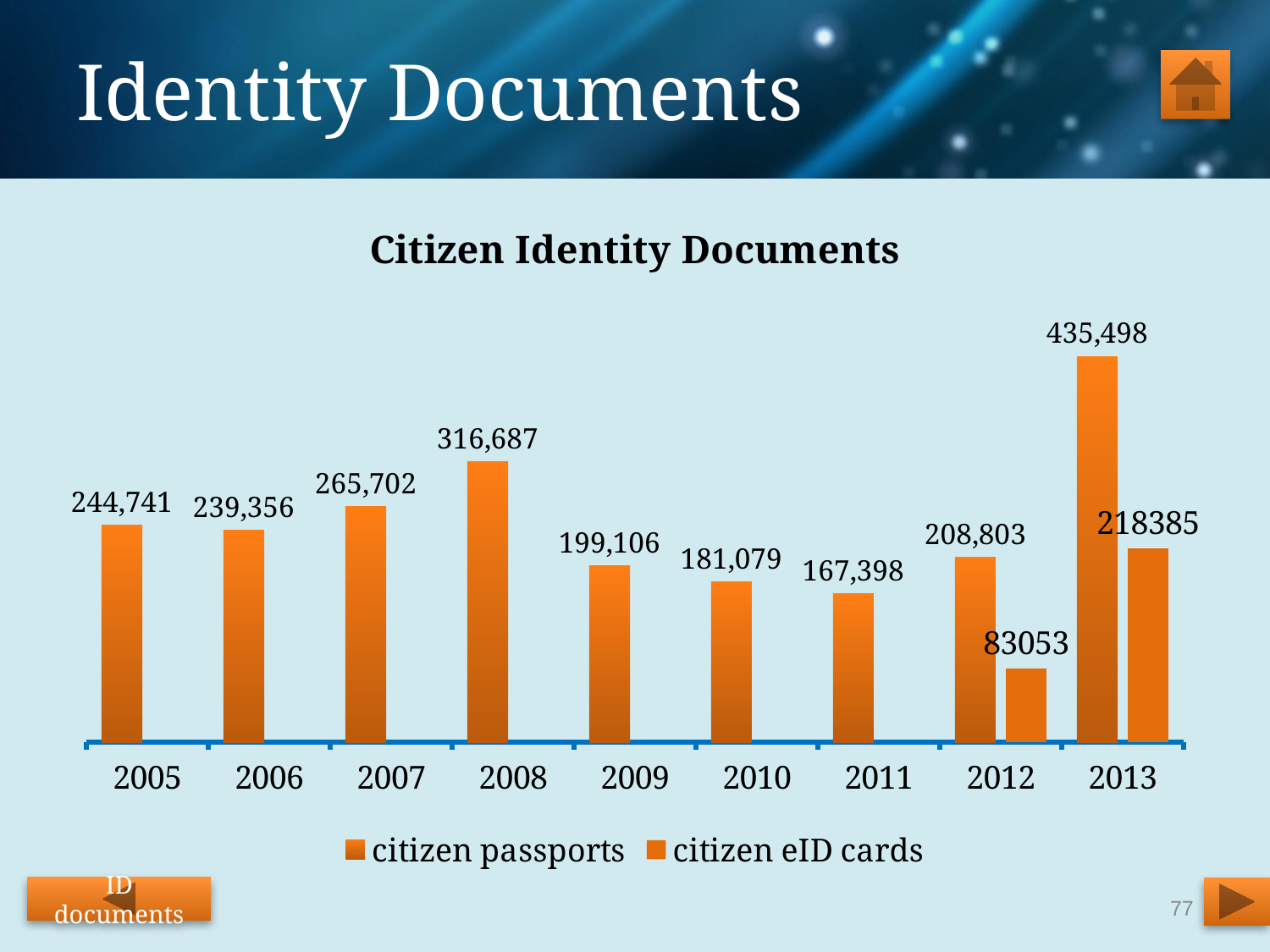
What is the value for citizen eID cards in 2013? 218385 What is the difference between the citizen passports values for 2008 and 2007? 50,985 Which is larger, the citizen passports value in 2009 or in 2010? 2009 What is the value for citizen passports in 2011? 167,398 What is the difference between citizen passports and citizen eID cards in 2013? 217,113 In which year is the citizen passports value highest? 2013 What is the value for citizen passports in 2008? 316,687 What is the value for citizen eID cards in 2012? 83053 What kind of chart is shown on the slide? Bar chart How many years are shown on the x axis? 9 In which year is the citizen passports value lowest? 2011 How many series does the legend list? 2